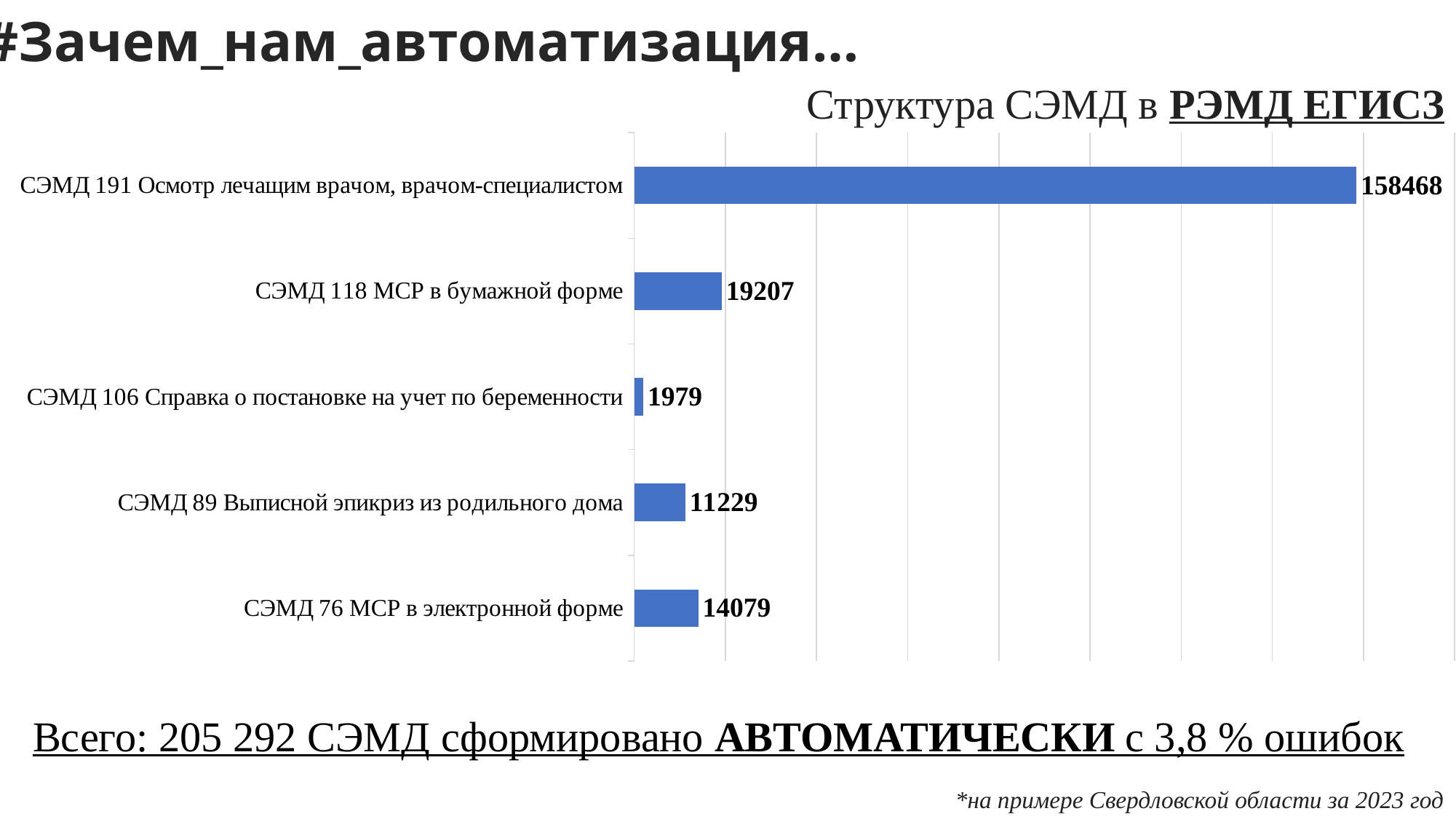
Which is larger: the value for СЭМД 89 Выписной эпикриз из родильного дома or СЭМД 76 МСР в электронной форме? СЭМД 76 МСР в электронной форме Which category has the highest value? СЭМД 191 Осмотр лечащим врачом, врачом-специалистом What type of chart is shown on the slide? Bar chart Which category has the lowest value? СЭМД 106 Справка о постановке на учет по беременности What is the value for СЭМД 191 Осмотр лечащим врачом, врачом-специалистом? 158468 What is the difference between the values for СЭМД 118 МСР в бумажной форме and СЭМД 76 МСР в электронной форме? 5128 How many categories are shown in the chart? 5 What is the value for СЭМД 118 МСР в бумажной форме? 19207 What is the value for СЭМД 106 Справка о постановке на учет по беременности? 1979 What is the value for СЭМД 89 Выписной эпикриз из родильного дома? 11229 What is the difference between the values for СЭМД 76 МСР в электронной форме and СЭМД 89 Выписной эпикриз из родильного дома? 2850 What is the value for СЭМД 76 МСР в электронной форме? 14079